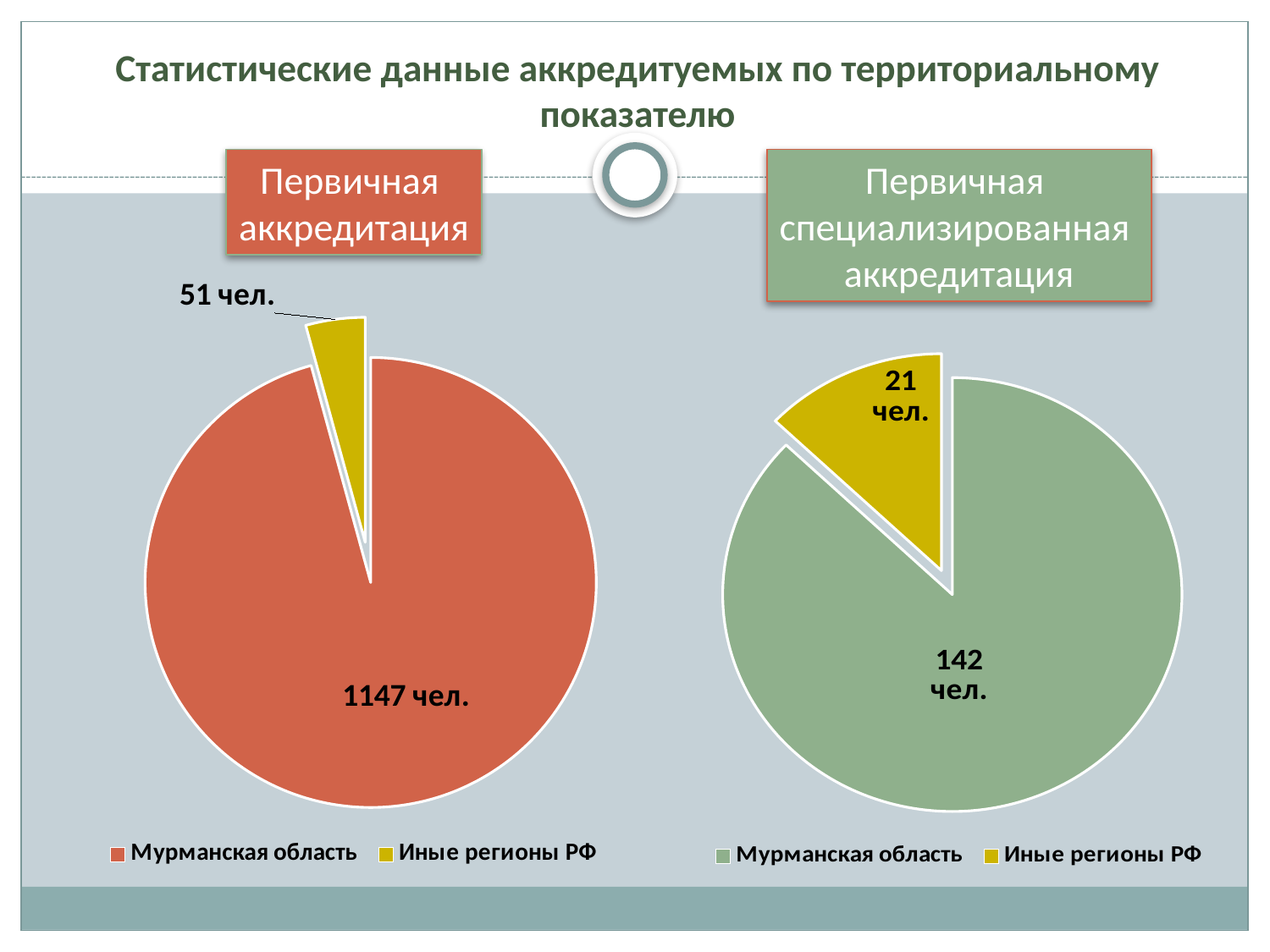
In the 'Первичная аккредитация' chart, what is the value for Мурманская область? 1147 чел. In the 'Первичная аккредитация' chart, what colour is the slice for Иные регионы РФ? Yellow In the 'Первичная аккредитация' chart, what is the difference between Мурманская область and Иные регионы РФ? 1096 чел. In the 'Первичная специализированная аккредитация' chart, what is the difference between Мурманская область and Иные регионы РФ? 121 чел. In the 'Первичная аккредитация' chart, what is the value for Иные регионы РФ? 51 чел. In the 'Первичная специализированная аккредитация' chart, which category has the smallest slice? Иные регионы РФ In the 'Первичная специализированная аккредитация' chart, what is the value for Иные регионы РФ? 21 чел. Which is larger: Иные регионы РФ in the 'Первичная аккредитация' chart or Иные регионы РФ in the 'Первичная специализированная аккредитация' chart? Иные регионы РФ in the 'Первичная аккредитация' chart In the 'Первичная аккредитация' chart, which category has the largest slice? Мурманская область How many categories does the 'Первичная специализированная аккредитация' chart show? 2 What type of chart is used on the left side of the slide? Pie chart In the 'Первичная специализированная аккредитация' chart, what is the value for Мурманская область? 142 чел.